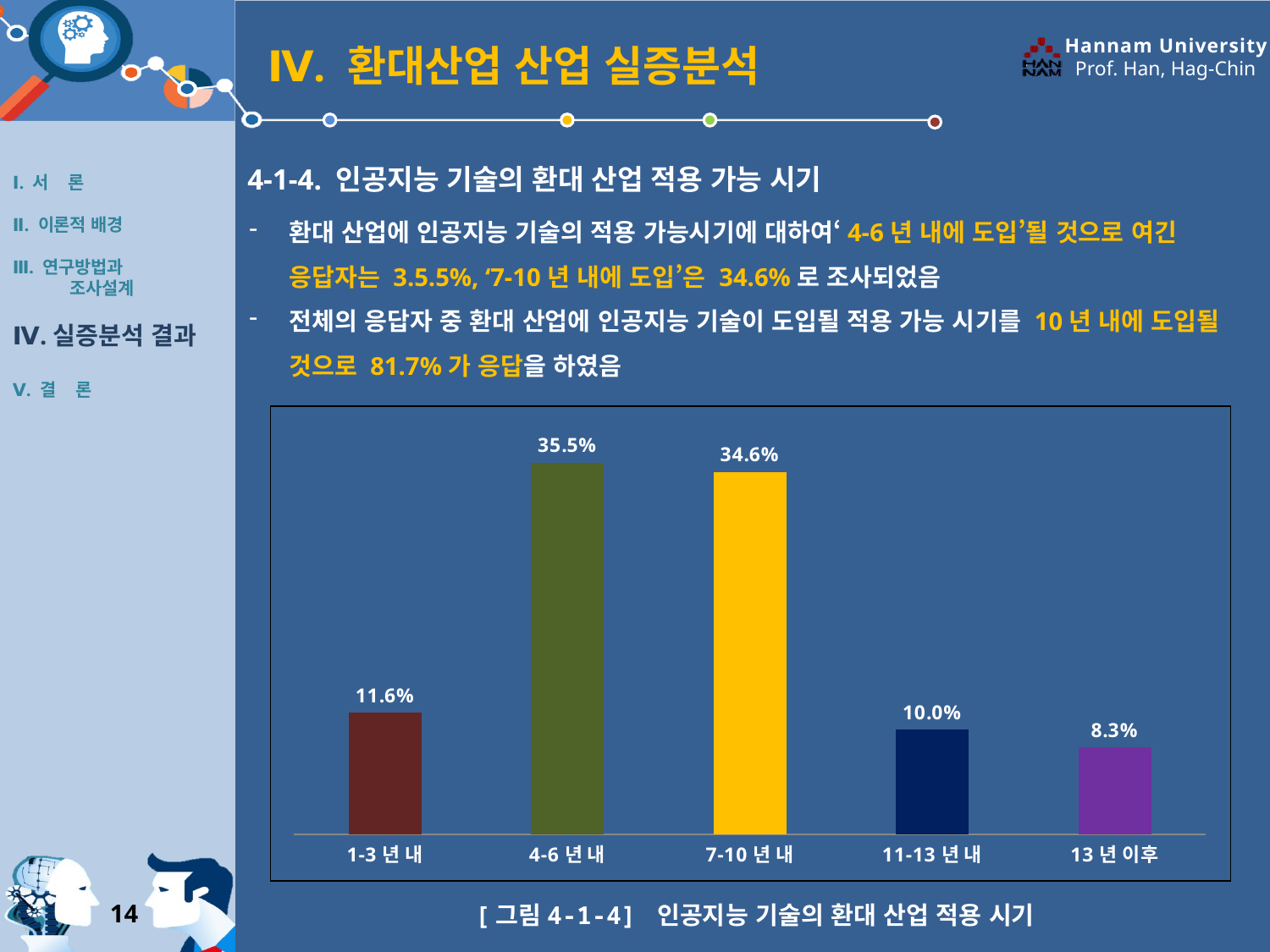
What is the difference between the values for '4-6 년 내' and '7-10 년 내'? 0.9% How many categories are shown on the x axis? 5 What kind of chart is shown on the slide? Bar chart What is the value for the '4-6 년 내' category? 35.5% What is the value for the '13 년 이후' category? 8.3% Which category has the highest value? 4-6 년 내 Which category has the lowest value? 13 년 이후 Which is larger, the value for '1-3 년 내' or the value for '11-13 년 내'? 1-3 년 내 What is the value for the '1-3 년 내' category? 11.6% What is the difference between the values for '1-3 년 내' and '11-13 년 내'? 1.6% Do the values rise or fall from '7-10 년 내' to '13 년 이후'? Fall What is the value for the '7-10 년 내' category? 34.6%